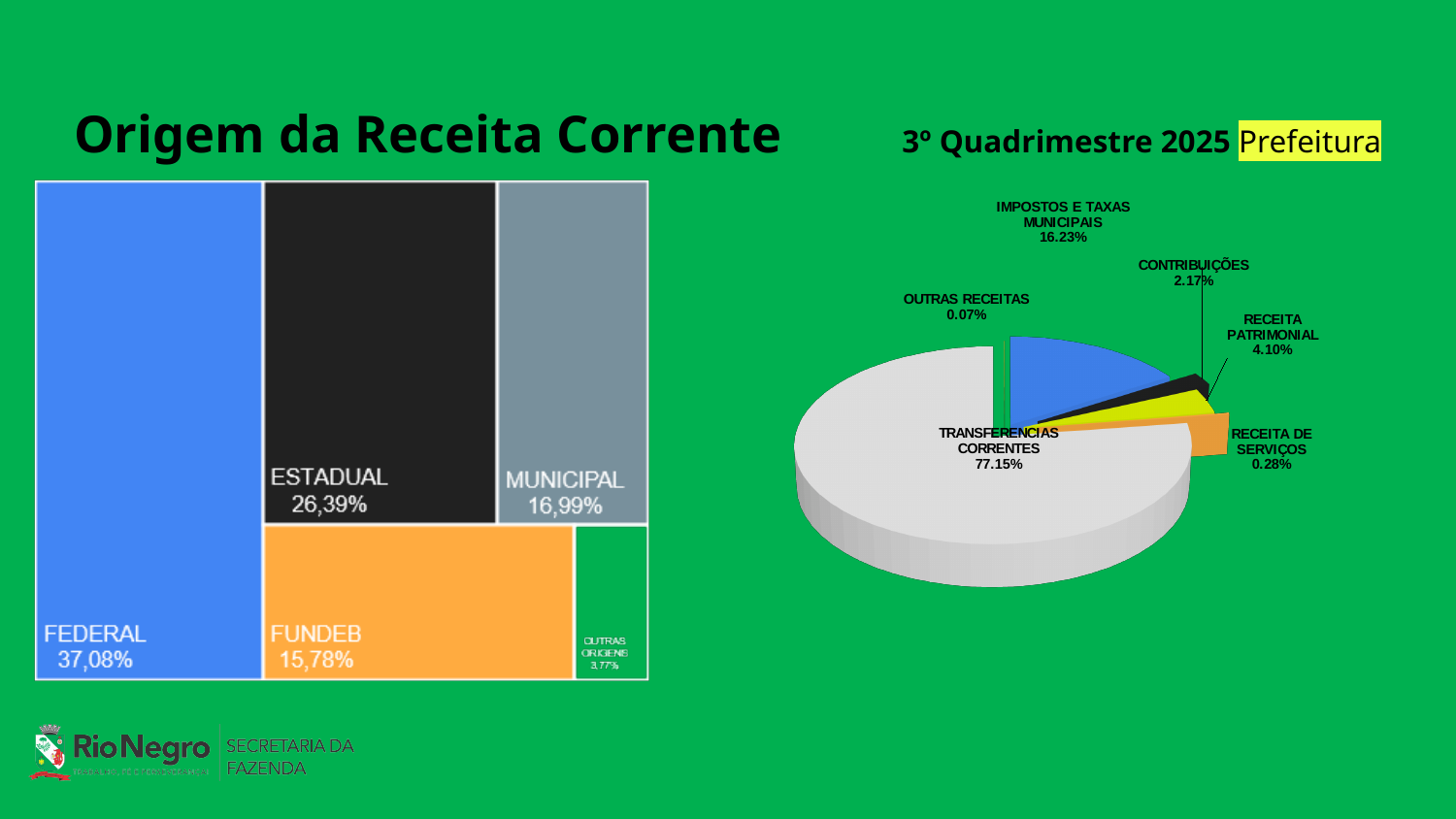
How many slices does the right pie chart (3º Quadrimestre 2025 Prefeitura) have? 6 In the left chart (Origem da Receita Corrente), what is the value for FEDERAL? 37,08% In the left chart (Origem da Receita Corrente), what is the difference between ESTADUAL and MUNICIPAL? 9,40% How many categories are shown in the left chart (Origem da Receita Corrente)? 5 In the right pie chart (3º Quadrimestre 2025 Prefeitura), what share does TRANSFERÊNCIAS CORRENTES have? 77.15% In the left chart (Origem da Receita Corrente), what is the value for FUNDEB? 15,78% In the left chart (Origem da Receita Corrente), which is larger, MUNICIPAL or FUNDEB? MUNICIPAL In the right pie chart (3º Quadrimestre 2025 Prefeitura), what is the value for RECEITA PATRIMONIAL? 4.10% In the left chart (Origem da Receita Corrente), which category has the lowest value? OUTRAS ORIGENS In the left chart (Origem da Receita Corrente), which category has the highest value? FEDERAL What kind of chart is the right chart (3º Quadrimestre 2025 Prefeitura)? Pie chart In the right pie chart (3º Quadrimestre 2025 Prefeitura), which slice is the smallest? OUTRAS RECEITAS